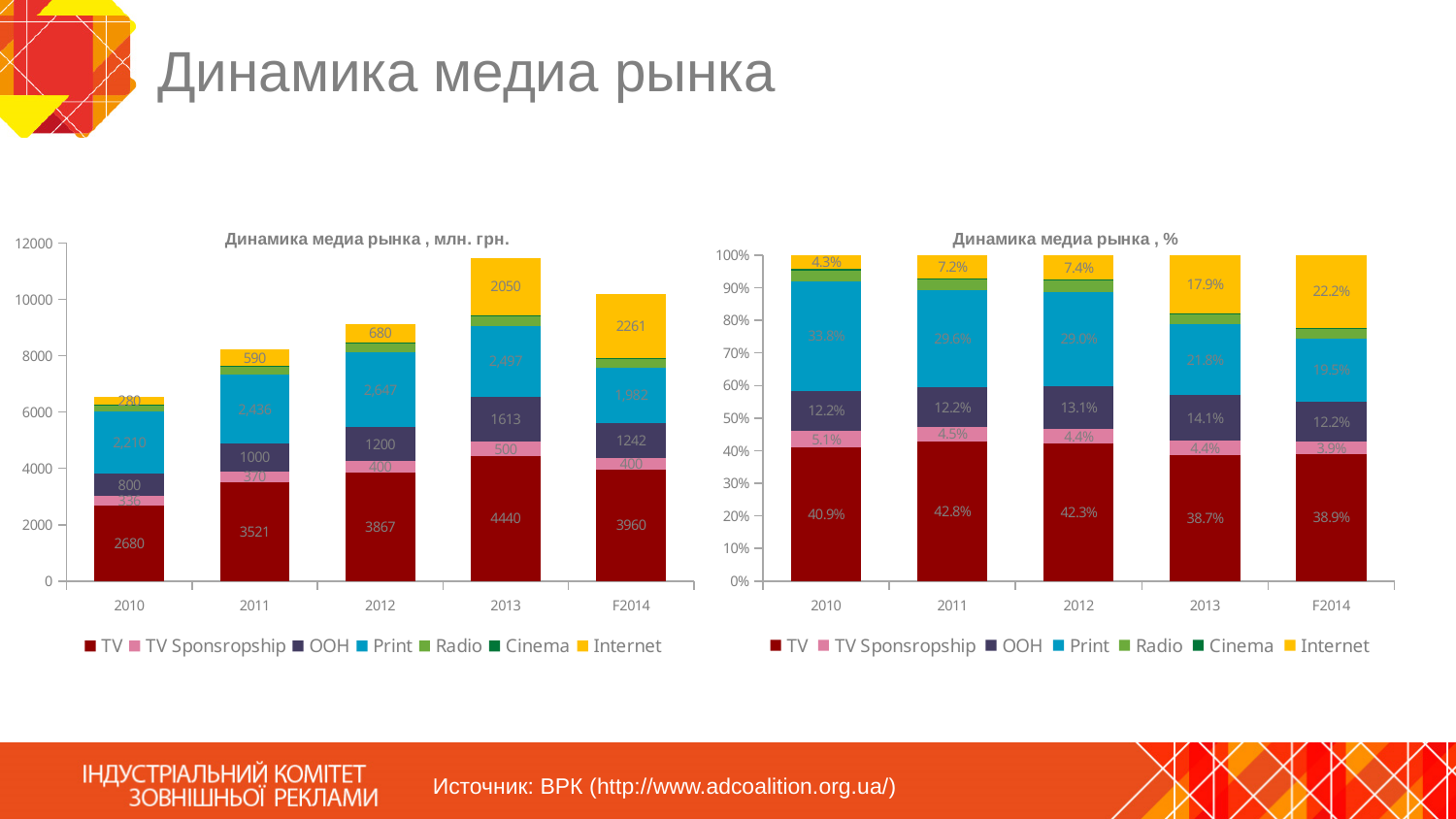
In the chart 'Динамика медиа рынка , %', is the TV share larger in 2011 or in 2013? 2011 What kind of chart is 'Динамика медиа рынка , %'? Stacked bar chart In the chart 'Динамика медиа рынка , млн. грн.', what is the value for TV in 2013? 4440 In the chart 'Динамика медиа рынка , млн. грн.', what is the value for Internet in F2014? 2261 In the chart 'Динамика медиа рынка , млн. грн.', what is the value for OOH in 2012? 1200 In the chart 'Динамика медиа рынка , млн. грн.', how many series does the legend list? 7 In the chart 'Динамика медиа рынка , %', does the Internet share rise or fall from 2010 to F2014? Rise In the chart 'Динамика медиа рынка , млн. грн.', what is the difference between the TV values for 2013 and F2014? 480 In the chart 'Динамика медиа рынка , %', what is the share of Internet in 2013? 17.9% In the chart 'Динамика медиа рынка , млн. грн.', how many years are shown on the x axis? 5 In the chart 'Динамика медиа рынка , млн. грн.', which year has the highest TV value? 2013 In the chart 'Динамика медиа рынка , %', which year has the lowest Print share? F2014